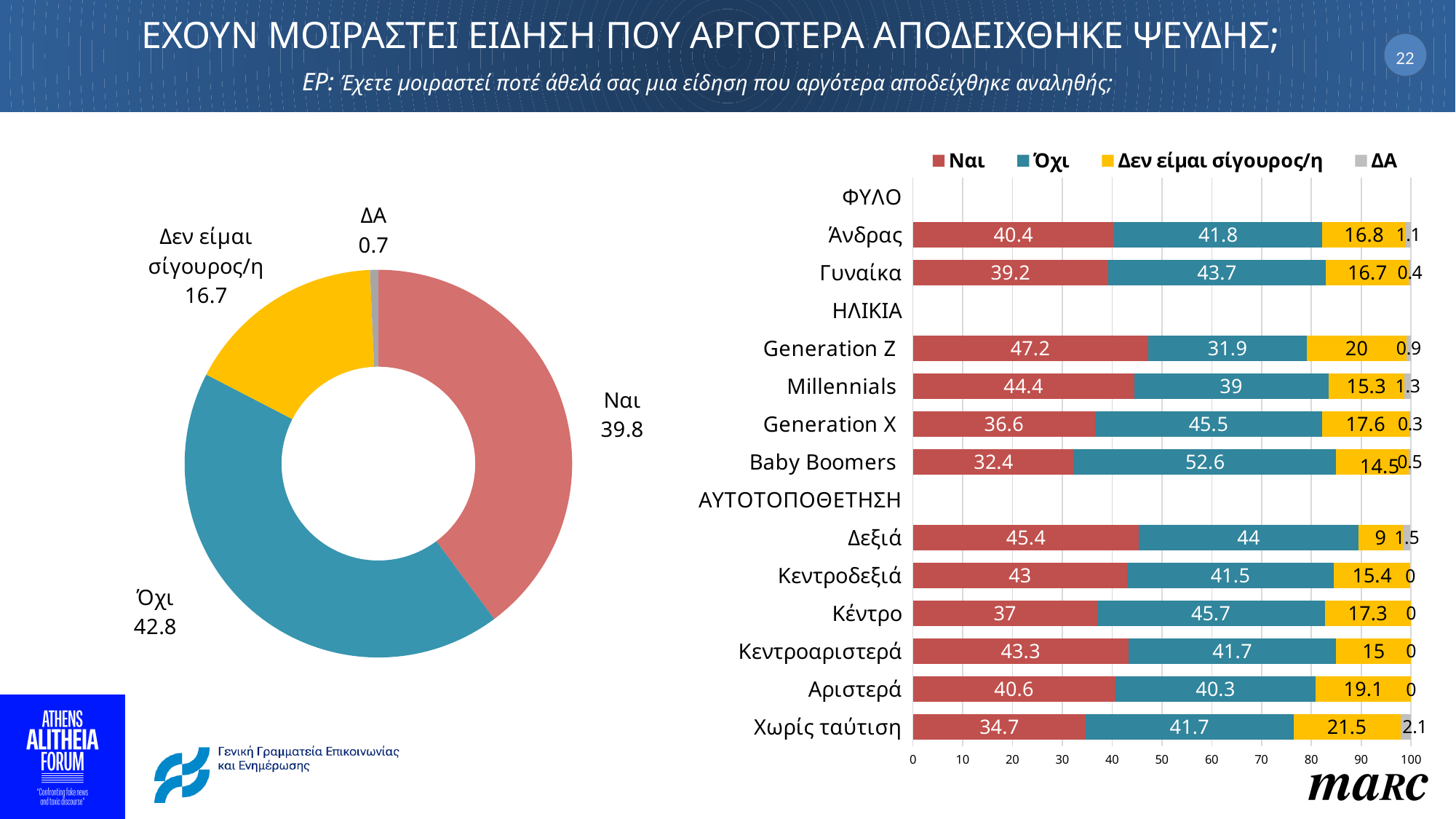
How many series does the legend of the stacked bar chart on the right list? 4 In the stacked bar chart on the right, which is larger: the Δεν είμαι σίγουρος/η value for Χωρίς ταύτιση or for Δεξιά? Χωρίς ταύτιση In the donut chart on the left, what is the difference between the values for Όχι and Ναι? 3 What kind of chart is shown on the left of the slide? Donut (pie) chart In the donut chart on the left, which category has the smallest share? ΔΑ In the stacked bar chart on the right, which category has the lowest Ναι value? Baby Boomers In the stacked bar chart on the right, which category has the highest Ναι value? Generation Z In the stacked bar chart on the right, what is the Ναι value for Generation Z? 47.2 In the stacked bar chart on the right, what is the difference between the Όχι values for Generation X and Millennials? 6.5 In the stacked bar chart on the right, what is the Όχι value for Baby Boomers? 52.6 In the donut chart on the left, what is the value for Όχι? 42.8 In the stacked bar chart on the right, what is the ΔΑ value for Άνδρας? 1.1